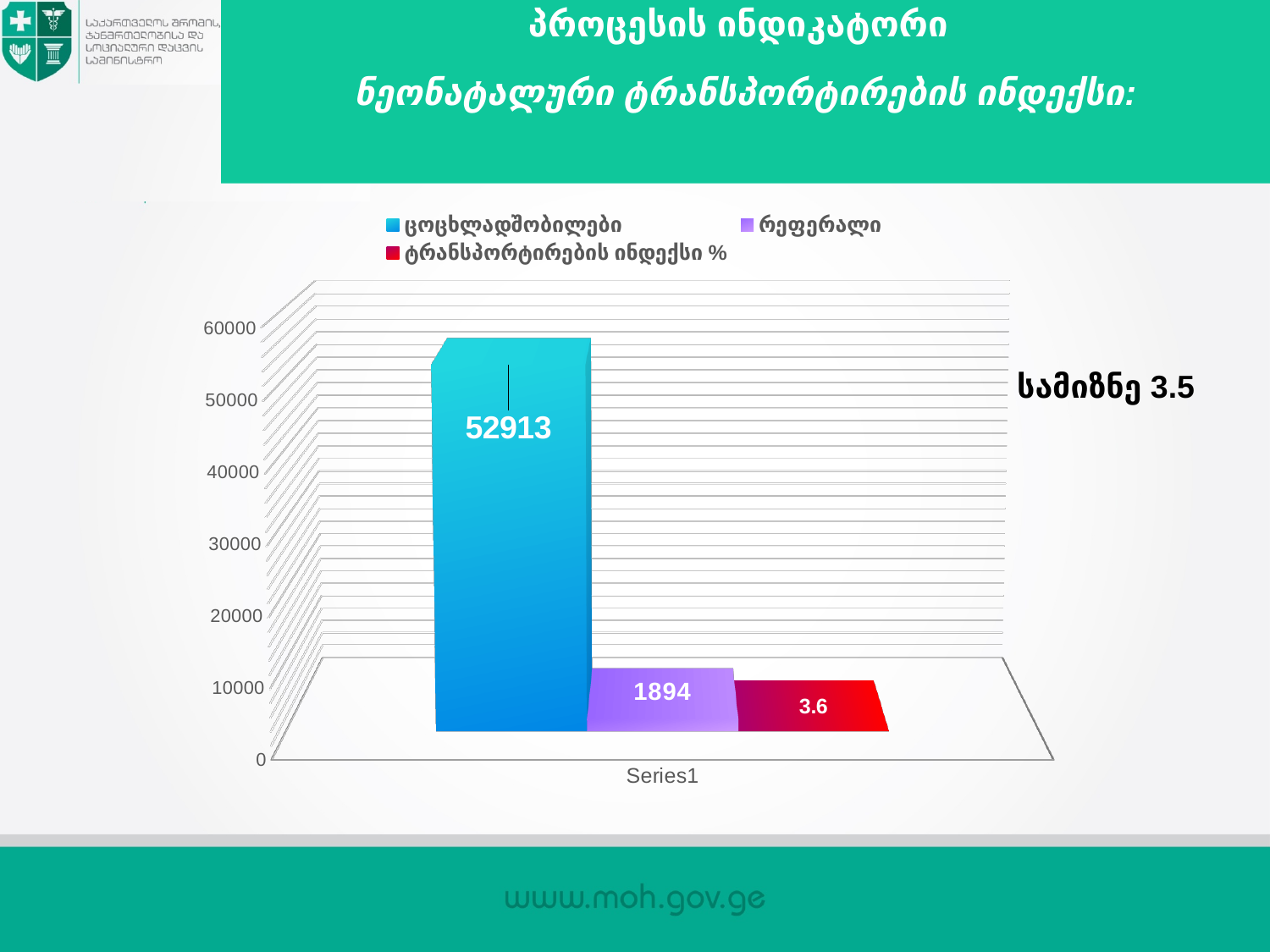
What is the difference between the ცოცხლადშობილები value and the რეფერალი value? 51019 What kind of chart is shown on the slide? bar chart What is the value of the ცოცხლადშობილები series? 52913 Which series has the highest value? ცოცხლადშობილები Which series has the lowest value? ტრანსპორტირების ინდექსი % What is the value of the რეფერალი series? 1894 Is the value for ცოცხლადშობილები greater or less than 50000? greater Which is larger, the რეფერალი value or the ტრანსპორტირების ინდექსი % value? რეფერალი What target value (სამიზნე) is written next to the chart? 3.5 What is the value of the ტრანსპორტირების ინდექსი % series? 3.6 What is the category label shown on the x axis? Series1 How many series does the legend list? 3